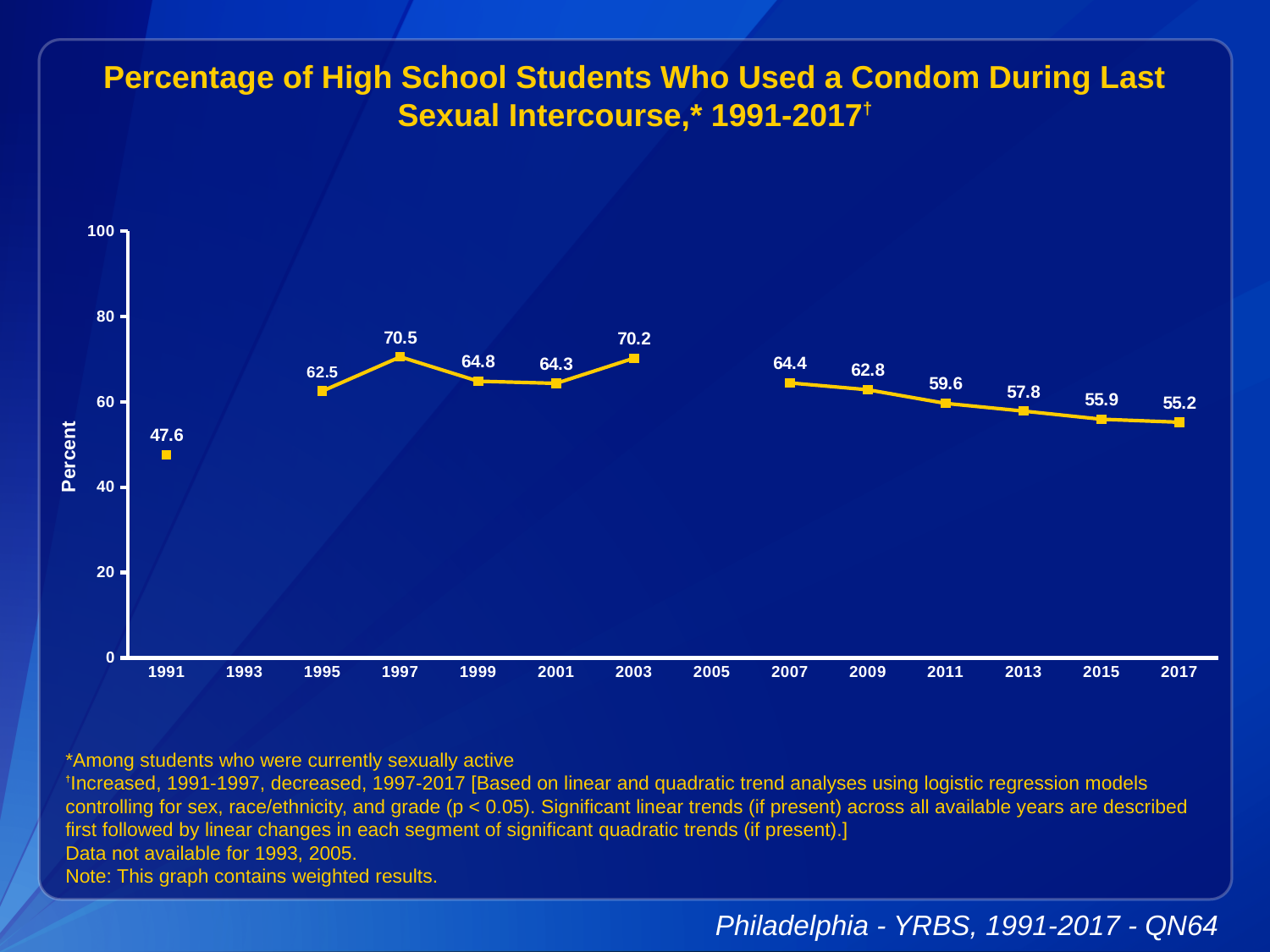
What is the difference between the values for 1997 and 2017? 15.3 Which is larger, the value for 1999 or the value for 2009? 1999 Which year has the lowest value on the chart? 1991 Which year has the highest value on the chart? 1997 How many years have data points plotted on the chart? 12 What value is shown for 2017? 55.2 What was the percentage of high school students who used a condom during last sexual intercourse in 1991? 47.6 What kind of chart is shown on the slide? line chart What is the difference between the values for 2003 and 2007? 5.8 Is the value for 2013 greater or less than 60? less What value is shown for 2007? 64.4 Do the values rise or fall from 2007 to 2017? fall